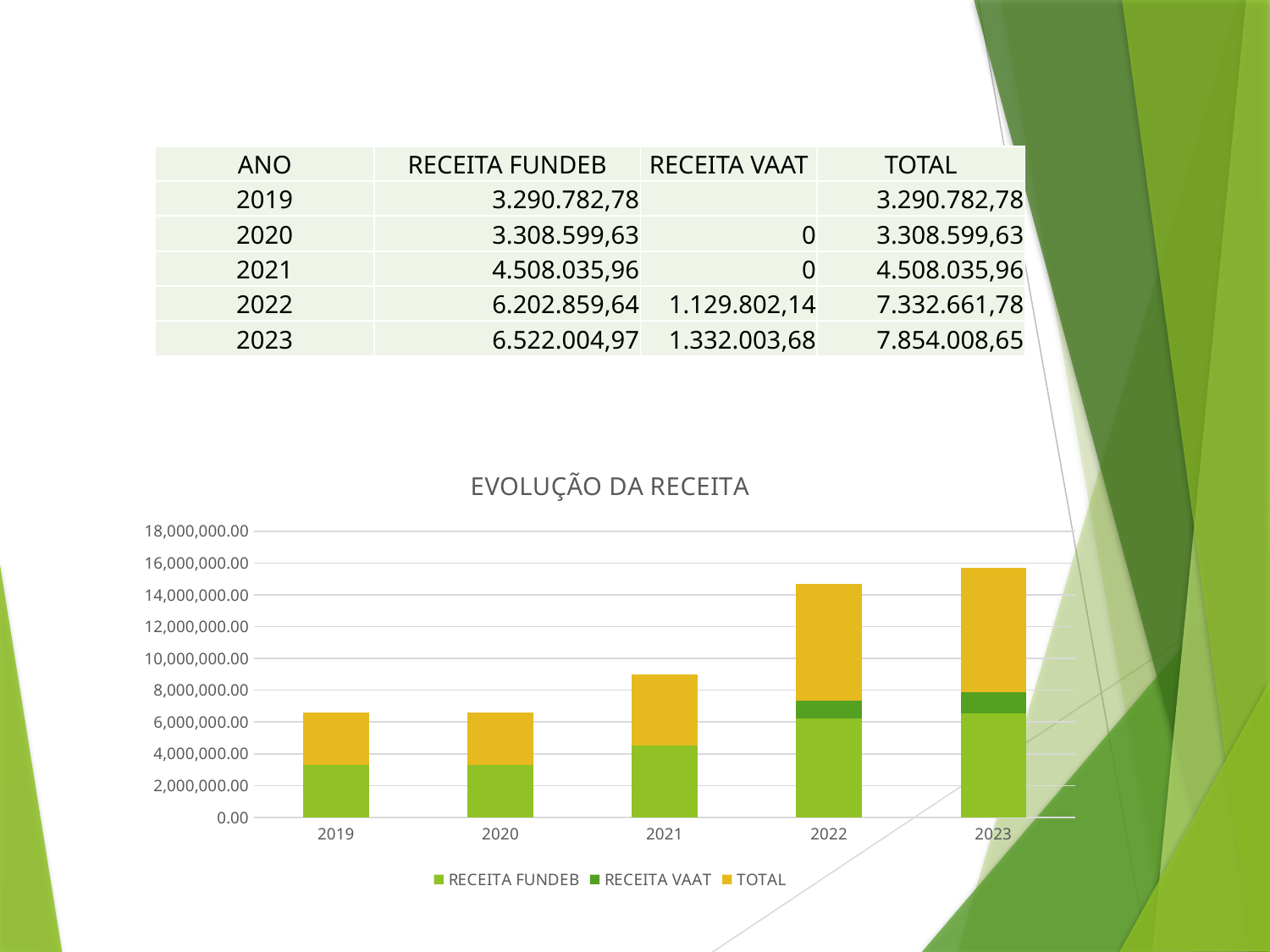
Which stacked bar is taller, 2021 or 2022? 2022 Is the top of the stacked bar for 2021 greater or less than 8,000,000.00? greater How many series does the chart legend list? 3 Do the stacked bar heights generally rise or fall from 2019 to 2023? Rise Which year has the tallest stacked bar in the chart? 2023 According to the table, what is the RECEITA FUNDEB value for 2021? 4.508.035,96 Using the table values, what is the difference between RECEITA FUNDEB in 2023 and in 2022? 319.145,33 According to the table, what is the RECEITA VAAT value for 2022? 1.129.802,14 What is the title of the chart on the slide? EVOLUÇÃO DA RECEITA How many years are shown on the x axis of the chart? 5 What kind of chart is shown under the title EVOLUÇÃO DA RECEITA? Stacked bar chart Is the top of the stacked bar for 2022 greater or less than 14,000,000.00? greater